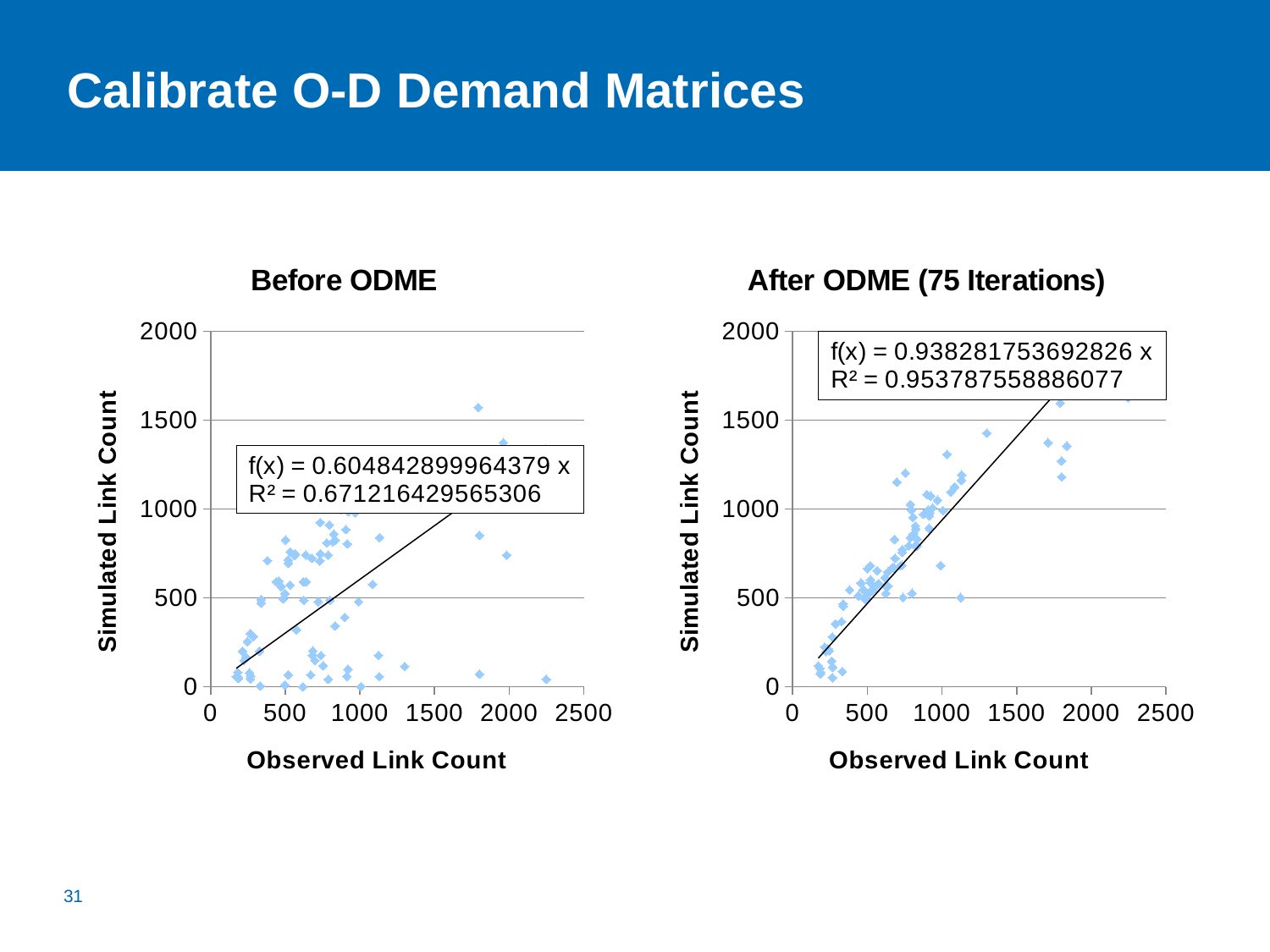
In the "After ODME (75 Iterations)" chart, do the simulated link counts generally rise or fall as the observed link count increases? rise In the "After ODME (75 Iterations)" chart, what is the R² value shown for the trendline? 0.953787558886077 Which chart has the larger trendline slope, "Before ODME" or "After ODME (75 Iterations)"? After ODME (75 Iterations) What is the x-axis label of the "Before ODME" chart? Observed Link Count What is the difference between the R² values of the "After ODME (75 Iterations)" chart and the "Before ODME" chart? 0.282571129320771 In the "After ODME (75 Iterations)" chart, what is the trendline equation shown? f(x) = 0.938281753692826 x What is the title of the chart on the right side of the slide? After ODME (75 Iterations) Is the R² value in the "Before ODME" chart greater or less than 0.9? less In the "Before ODME" chart, what is the trendline equation shown? f(x) = 0.604842899964379 x Which chart shows the higher R² value, "Before ODME" or "After ODME (75 Iterations)"? After ODME (75 Iterations) In the "Before ODME" chart, what is the R² value shown for the trendline? 0.671216429565306 What kind of chart is the "Before ODME" chart? scatter chart